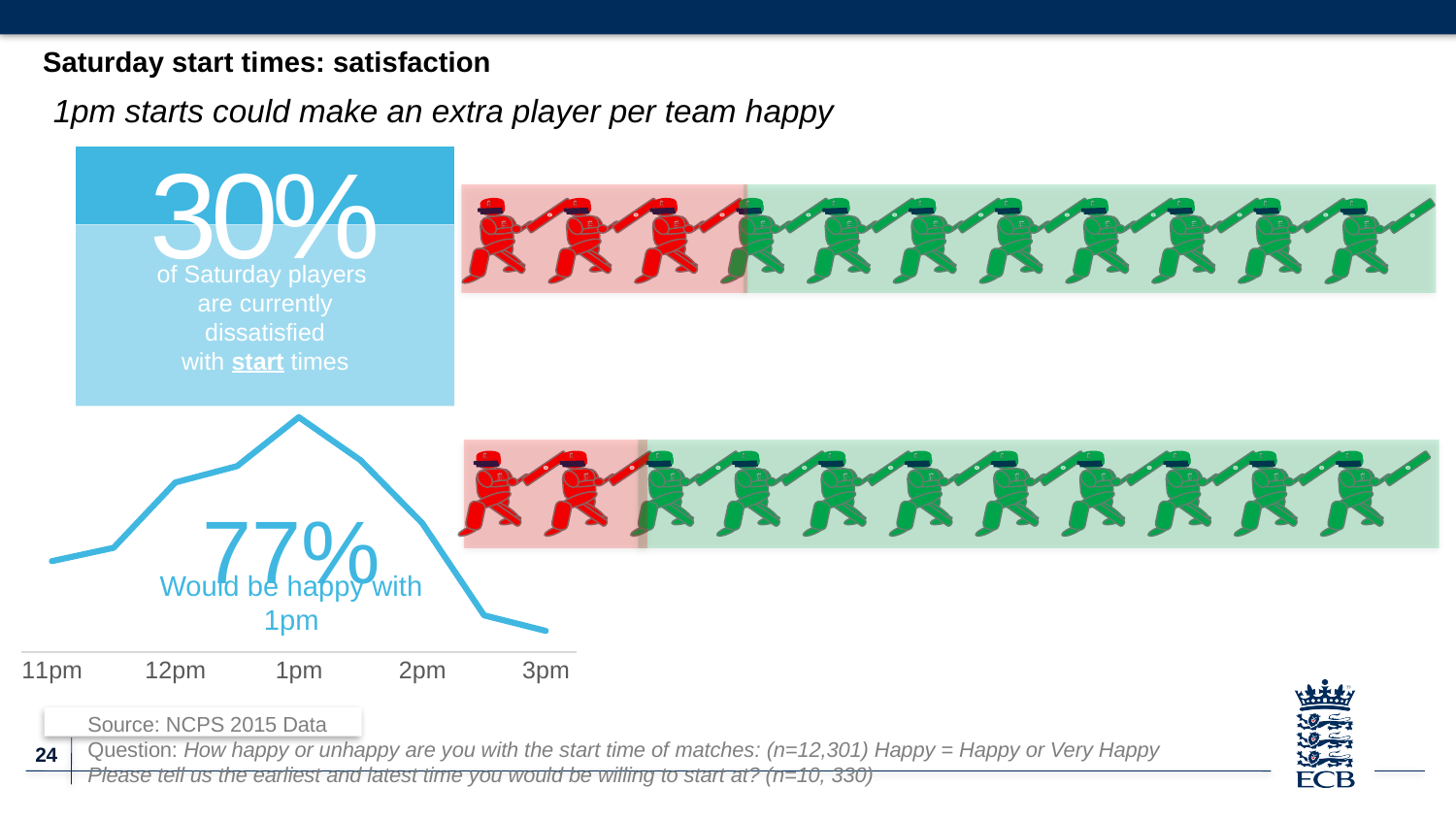
What percentage of Saturday players are currently dissatisfied with start times? 30% How many time categories are labelled on the x axis of the line chart? 5 Does the line rise or fall from 1pm to 3pm? fall On the line chart, which is higher: the point at 12pm or the point at 2pm? 12pm What is the data source cited on the slide? NCPS 2015 Data What percentage of players would be happy with a 1pm start, according to the slide? 77% How many cricketer figures are shown in the top pictogram row? 11 On the line chart, which is higher: the point at 11pm or the point at 3pm? 11pm Which start time has the highest point on the line chart? 1pm Does the line rise or fall from 11pm to 1pm? rise Which start time has the lowest point on the line chart? 3pm What kind of chart is shown at the bottom left of the slide? line chart